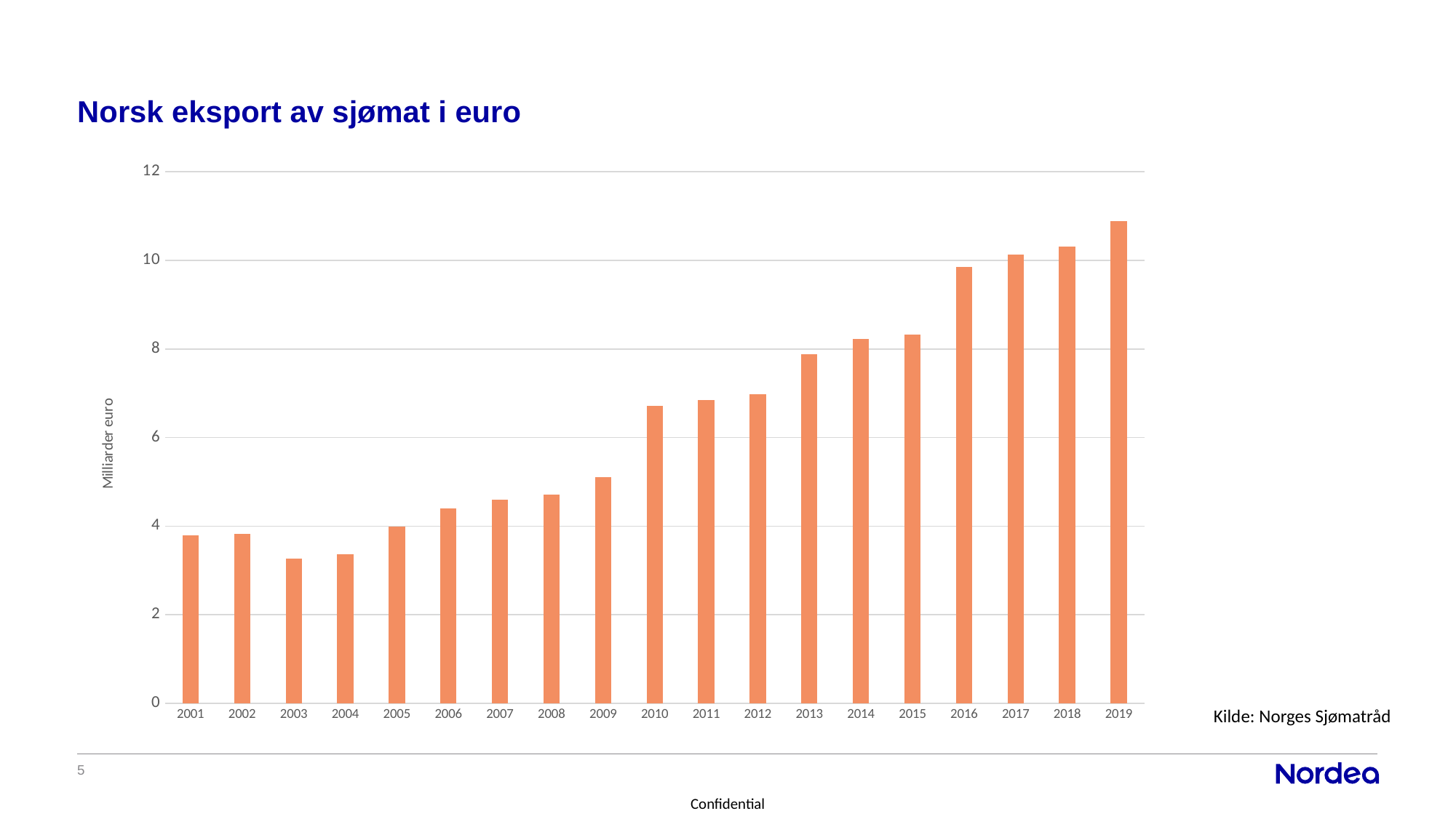
Is the value for 2013 greater or less than 8? less Which year has the lowest value? 2003 Is the value for 2019 greater or less than 10? greater Is the value for 2003 greater or less than 4? less Do the values generally rise or fall from 2003 to 2019? rise What is the label on the vertical axis? Milliarder euro What kind of chart is shown on the slide? bar chart What is the title of the chart? Norsk eksport av sjømat i euro Which is larger, the value for 2009 or the value for 2010? 2010 Which year has the highest value? 2019 How many years are shown on the x axis? 19